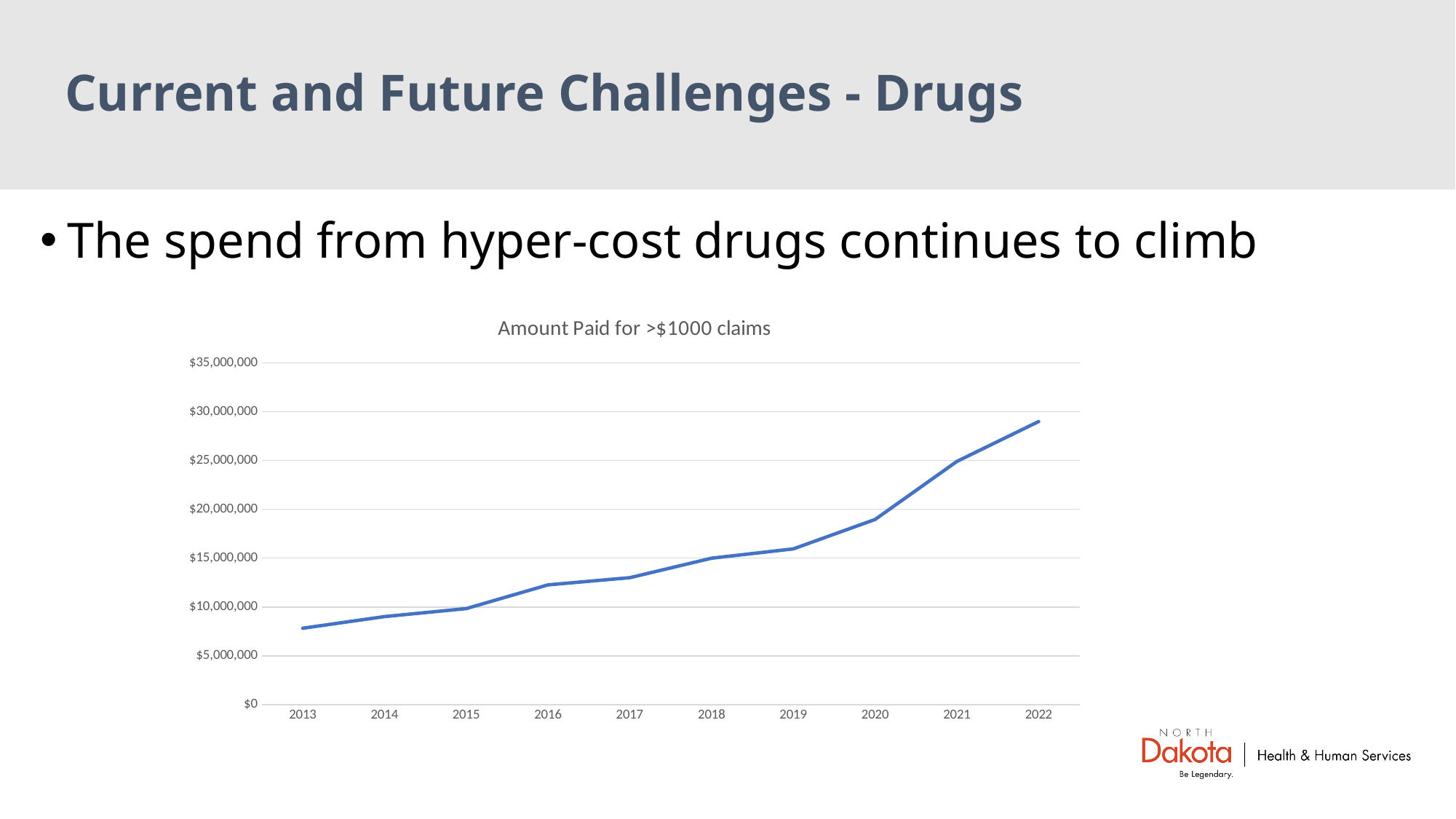
How many years are plotted on the x axis of the chart? 10 What is the title of the chart? Amount Paid for >$1000 claims Is the value for 2017 greater or less than $15,000,000? less Is the value for 2016 greater or less than $10,000,000? greater Which year has the lowest amount paid in the chart? 2013 Is the value for 2022 greater or less than $30,000,000? less Which year has the highest amount paid in the chart? 2022 What kind of chart is shown on the slide? line chart Do the values in the chart rise or fall from 2013 to 2022? rise Which year has the larger amount paid, 2017 or 2021? 2021